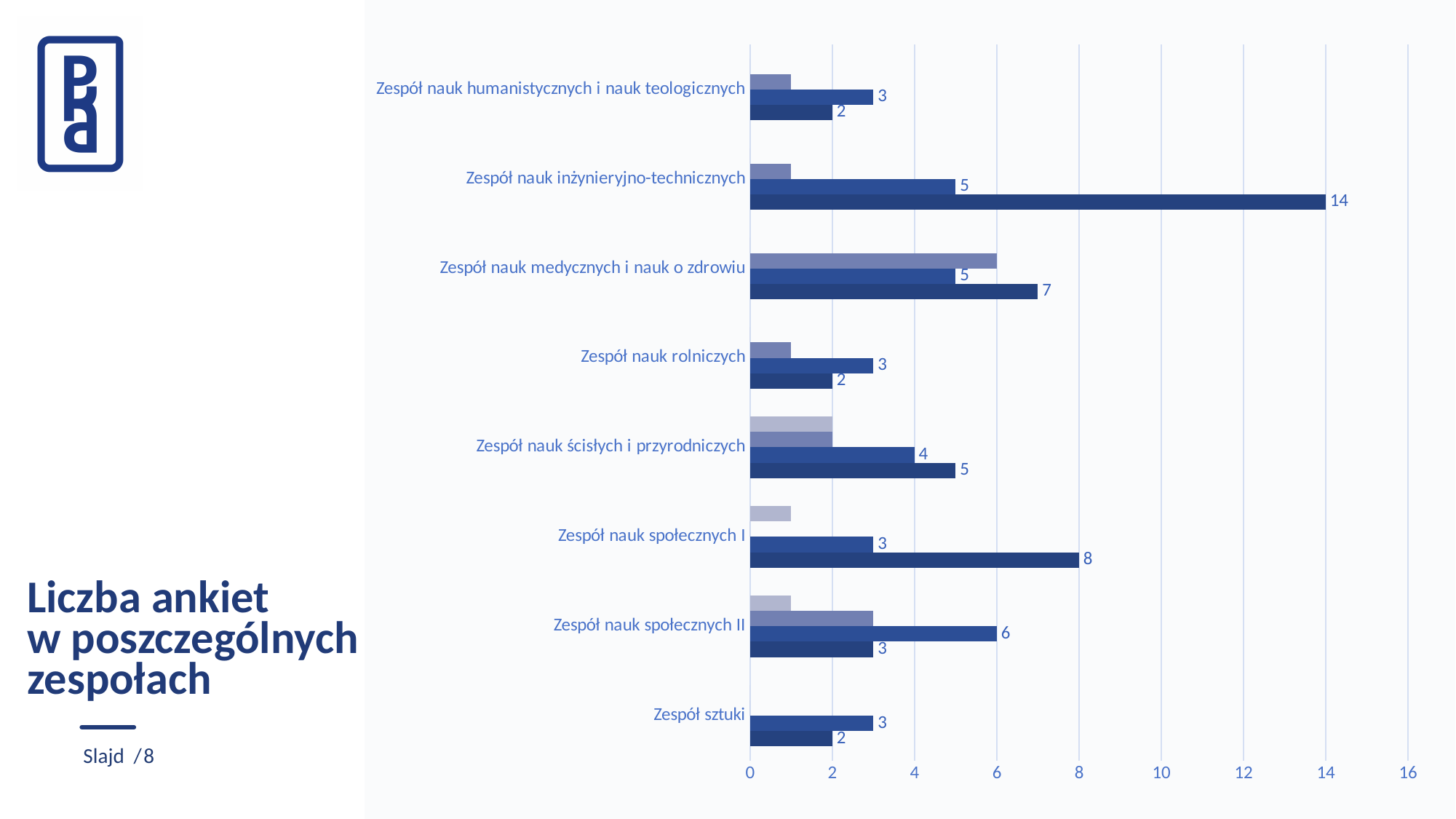
How many categories (zespoły) are listed on the chart? 8 What is the title of the slide's chart? Liczba ankiet w poszczególnych zespołach What is the value of the darkest (bottom) bar for Zespół nauk inżynieryjno-technicznych? 14 Is the value of the lightest (top) bar for Zespół nauk medycznych i nauk o zdrowiu greater or less than 4? greater What is the value of the medium-blue bar for Zespół nauk społecznych II? 6 What is the difference between the darkest bar values for Zespół nauk inżynieryjno-technicznych (14) and Zespół nauk społecznych I (8)? 6 What type of chart is shown on the slide? bar chart What is the value of the darkest (bottom) bar for Zespół nauk medycznych i nauk o zdrowiu? 7 Which category has the highest value among the darkest (bottom) bars? Zespół nauk inżynieryjno-technicznych Is the value of the lightest (top) bar for Zespół nauk rolniczych greater or less than 2? less For Zespół nauk medycznych i nauk o zdrowiu, which is larger: the medium-blue bar or the darkest bar? the darkest bar What is the value of the darkest (bottom) bar for Zespół nauk społecznych I? 8